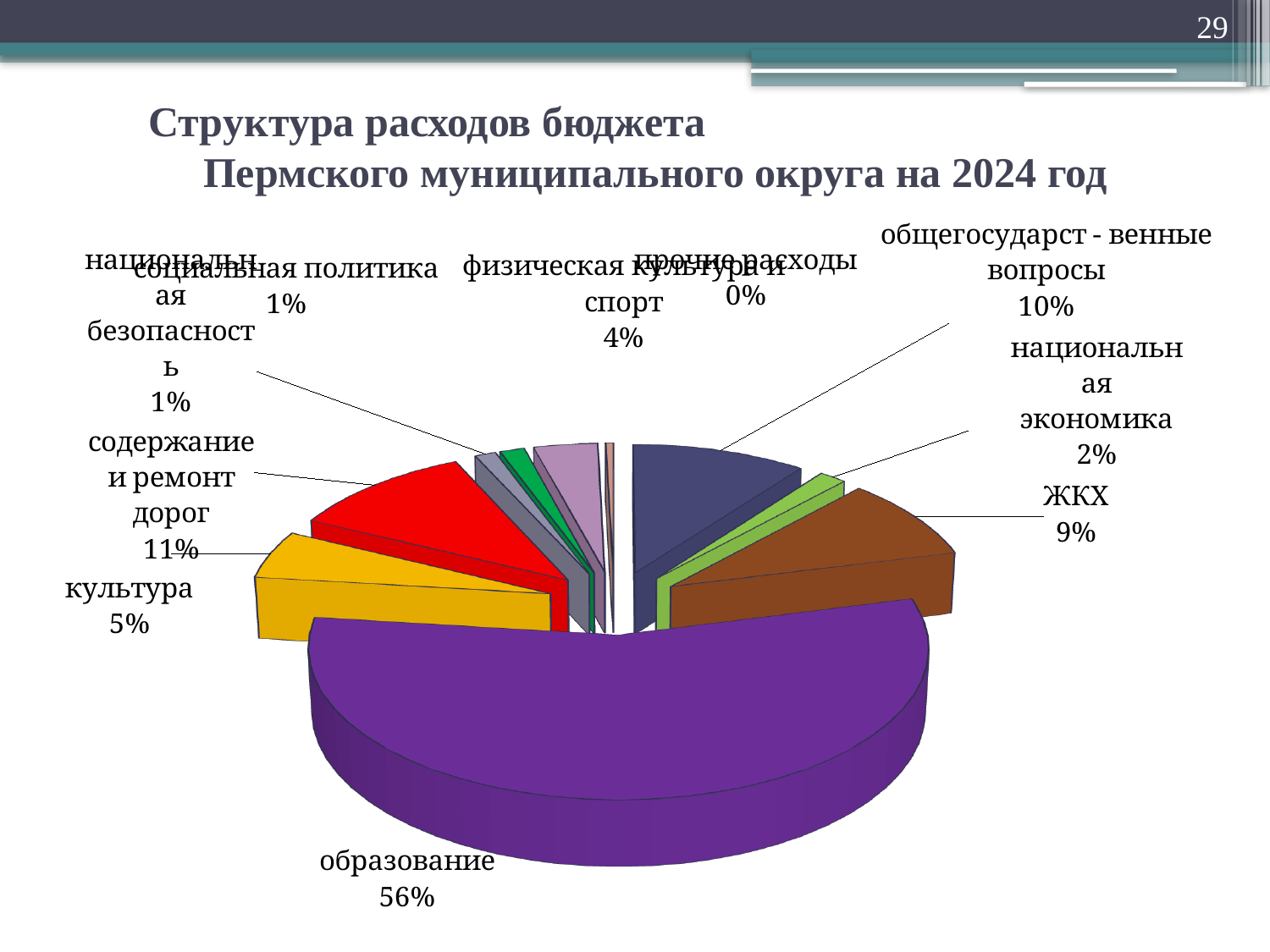
Which is larger, the share for ЖКХ or the share for культура? ЖКХ How many categories are shown in the pie chart? 10 What share of the budget expenditure goes to образование? 56% What is the difference in percentage points between образование and содержание и ремонт дорог? 45 What share is shown for общегосударственные вопросы? 10% What is the title of the chart on the slide? Структура расходов бюджета Пермского муниципального округа на 2024 год What share is shown for ЖКХ? 9% What share is shown for содержание и ремонт дорог? 11% Which category has the smallest share, shown as 0%? прочие расходы Which category has the largest share of the budget expenditure? образование What share is shown for физическая культура и спорт? 4% What kind of chart is shown on the slide? pie chart